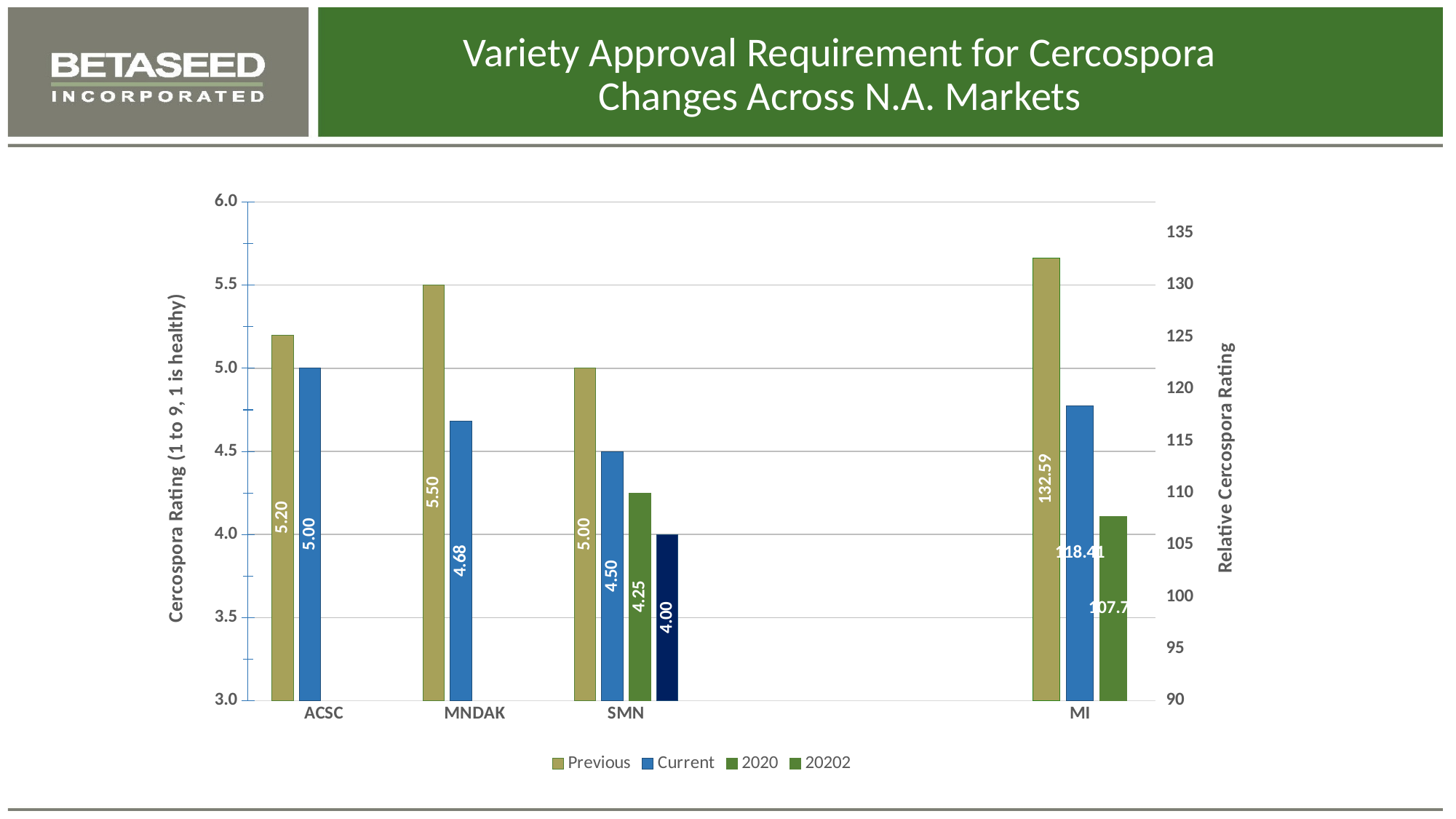
Among ACSC, MNDAK and SMN, which market has the highest Previous value? MNDAK What is the Current value for MNDAK? 4.68 What is the difference between the Previous and Current values for MNDAK? 0.82 What is the title of the right-hand vertical axis? Relative Cercospora Rating Which is larger, the Current value for ACSC or the Current value for SMN? ACSC What is the difference between the Previous and Current values for MI? 14.18 What is the Previous value for ACSC? 5.20 What is the Previous value for MI? 132.59 How many series does the legend list? 4